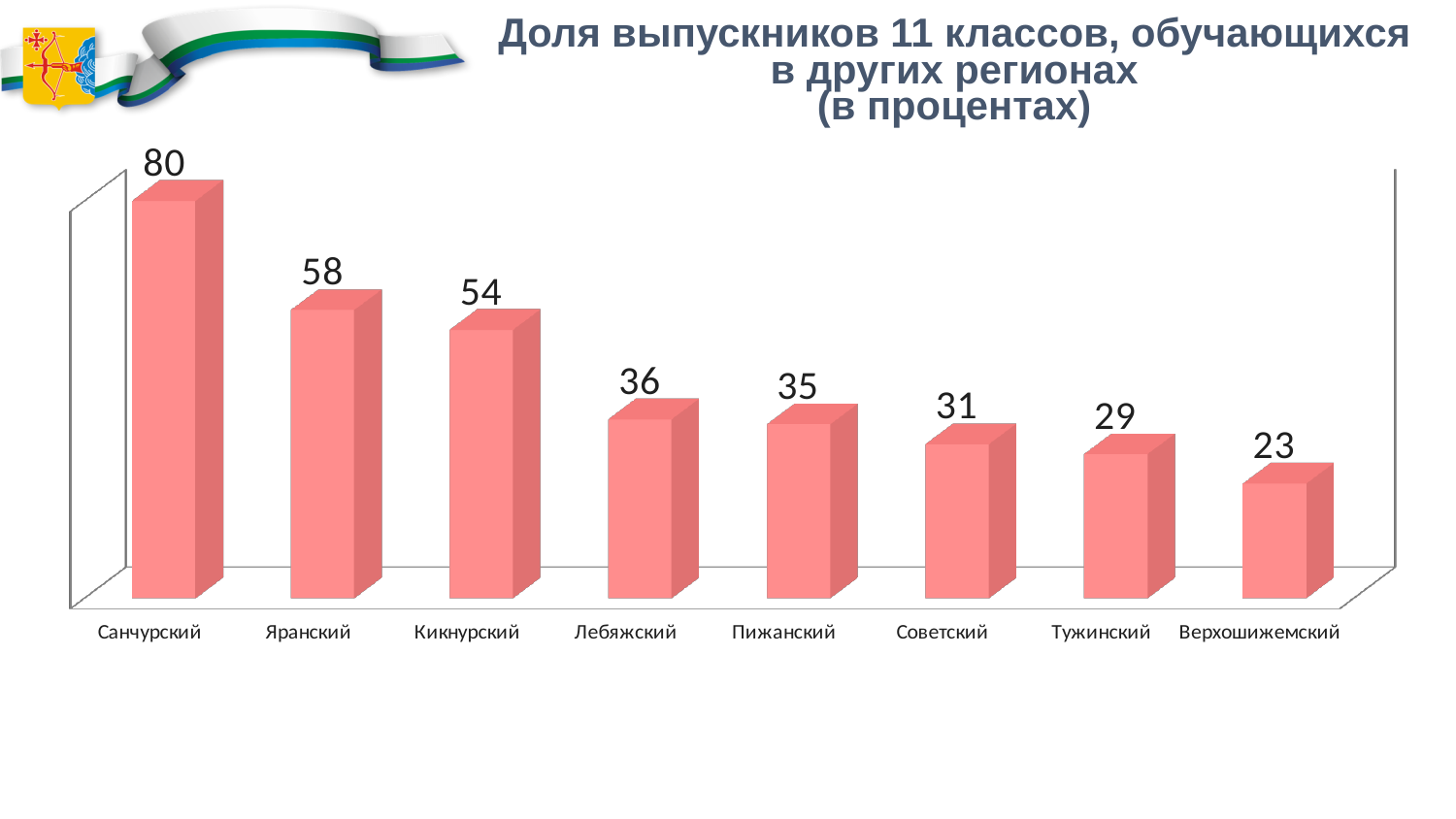
How many categories are shown in the chart? 8 Which is larger, the value for Советский or the value for Пижанский? Пижанский What is the value for Тужинский? 29 Which category has the highest value? Санчурский What is the difference between the values for Санчурский and Верхошижемский? 57 What is the title of the chart? Доля выпускников 11 классов, обучающихся в других регионах (в процентах) Which category has the lowest value? Верхошижемский What is the difference between the values for Яранский and Кикнурский? 4 What is the value for Лебяжский? 36 What kind of chart is shown on the slide? Bar chart Do the values rise or fall from left to right along the x axis? Fall What is the value for Санчурский? 80